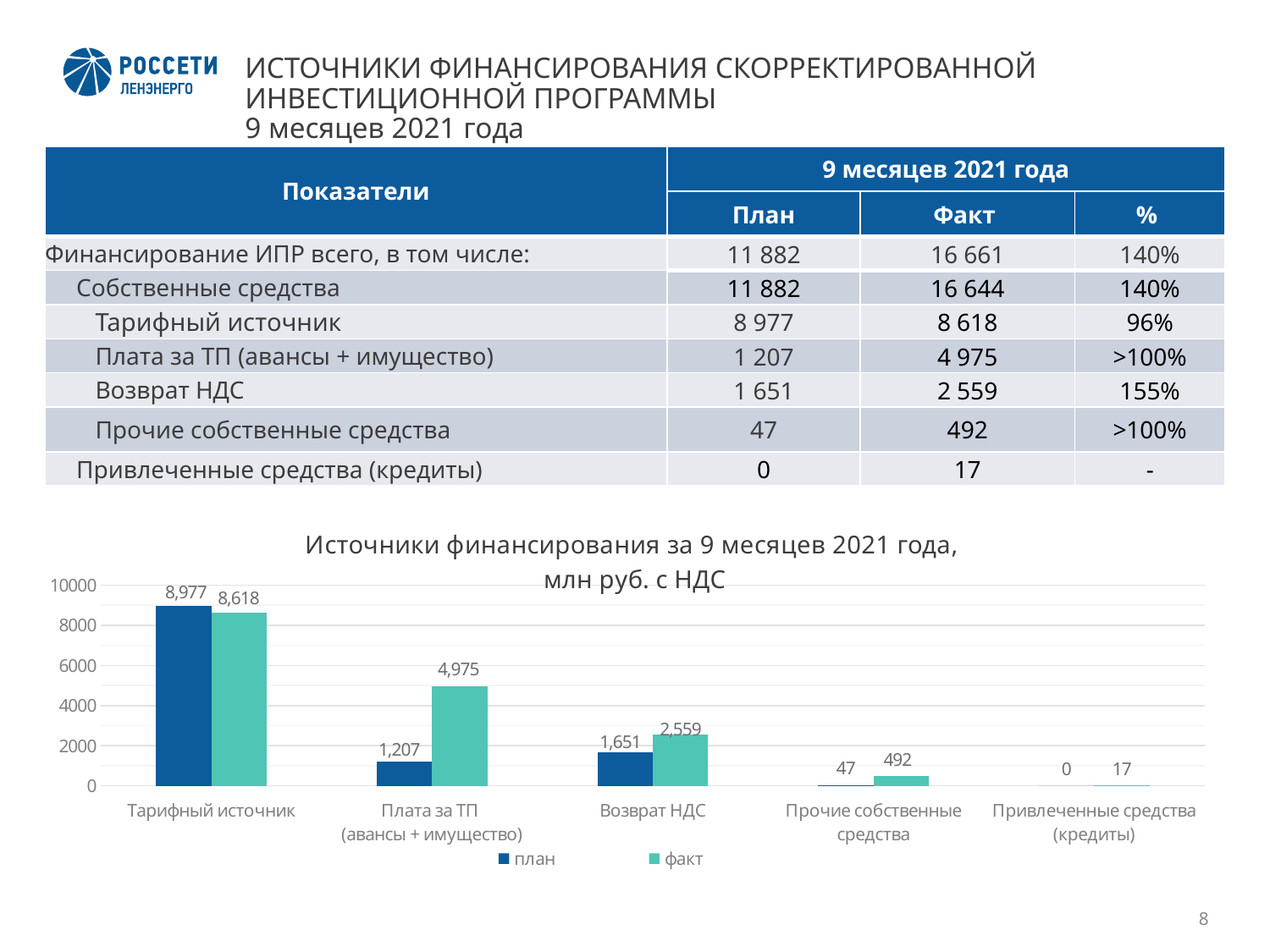
How many categories are shown on the x axis of the chart? 5 What is the difference between the план and факт values for Тарифный источник? 359 What is the difference between the факт and план values for Плата за ТП (авансы + имущество)? 3,768 What is the title of the chart? Источники финансирования за 9 месяцев 2021 года, млн руб. с НДС Which category has the highest план value in the chart? Тарифный источник What is the факт value for Тарифный источник in the chart? 8,618 What type of chart is shown on the slide? bar chart What is the план value for Плата за ТП (авансы + имущество) in the chart? 1,207 What is the факт value for Прочие собственные средства in the chart? 492 For Возврат НДС, which is larger: план or факт? факт Which category has the lowest факт value in the chart? Привлеченные средства (кредиты) How many series does the chart legend list? 2